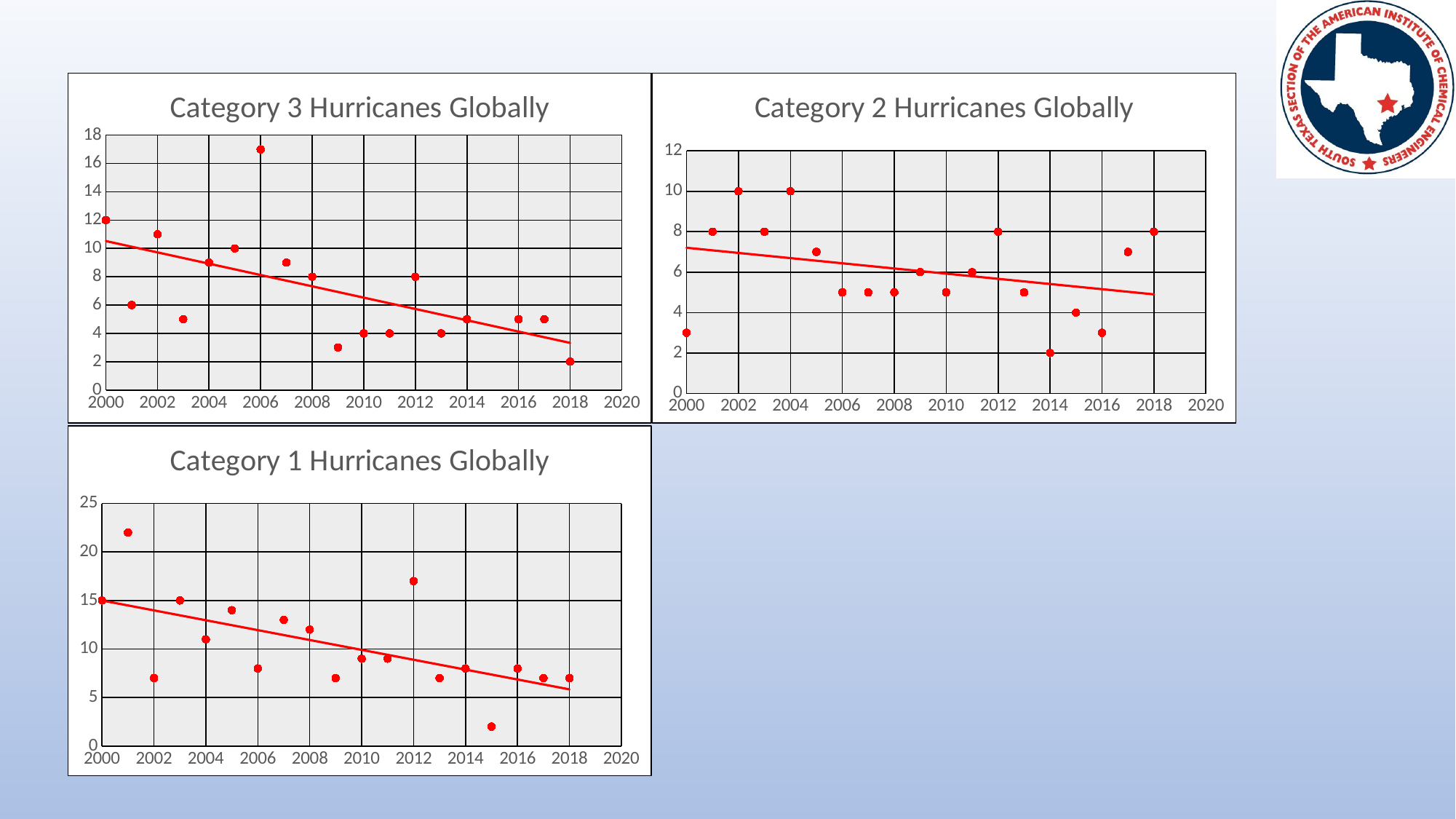
In the "Category 1 Hurricanes Globally" chart, which year has the lowest value? 2015 In the "Category 3 Hurricanes Globally" chart, does the trend line rise or fall from 2000 to 2018? fall In the "Category 3 Hurricanes Globally" chart, which year has the lowest value? 2018 In the "Category 2 Hurricanes Globally" chart, is the value for 2000 greater or less than 4? less In the "Category 2 Hurricanes Globally" chart, which year has the lowest value? 2014 In the "Category 1 Hurricanes Globally" chart, which is larger, the value for 2012 or the value for 2013? 2012 In the "Category 3 Hurricanes Globally" chart, what is the value for 2018? 2 In the "Category 1 Hurricanes Globally" chart, which year has the highest value? 2001 In the "Category 2 Hurricanes Globally" chart, what is the value for 2002? 10 In the "Category 3 Hurricanes Globally" chart, which year has the highest value? 2006 In the "Category 3 Hurricanes Globally" chart, what is the value for 2000? 12 What kind of chart is "Category 3 Hurricanes Globally"? scatter chart